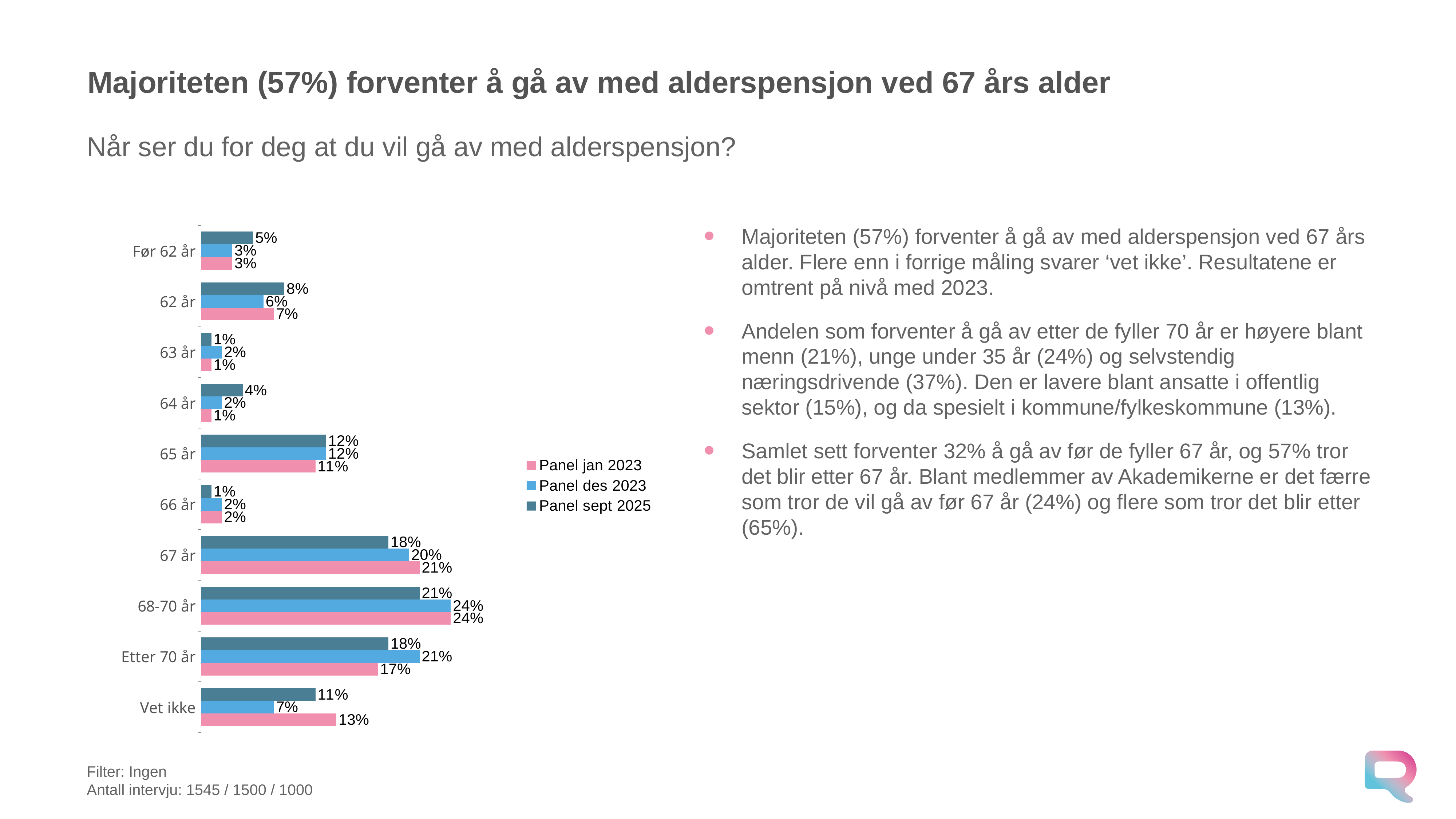
Which category has the highest value in the Panel sept 2025 series? 68-70 år What is the difference between the Panel des 2023 and Panel sept 2025 values for '68-70 år'? 3% Which series is shown in pink in the chart legend? Panel jan 2023 Which category has the lowest value in the Panel des 2023 series? 63 år, 64 år and 66 år (tied at 2%) What kind of chart is shown on the slide? Bar chart Which is larger for 'Etter 70 år': the Panel des 2023 value or the Panel jan 2023 value? Panel des 2023 How many categories are shown on the chart? 10 What is the value for 'Vet ikke' in the Panel des 2023 series? 7% How many series does the chart legend list? 3 What is the difference between the Panel jan 2023 and Panel sept 2025 values for 'Vet ikke'? 2% What is the value for 'Etter 70 år' in the Panel jan 2023 series? 17% What is the value for '67 år' in the Panel sept 2025 series? 18%